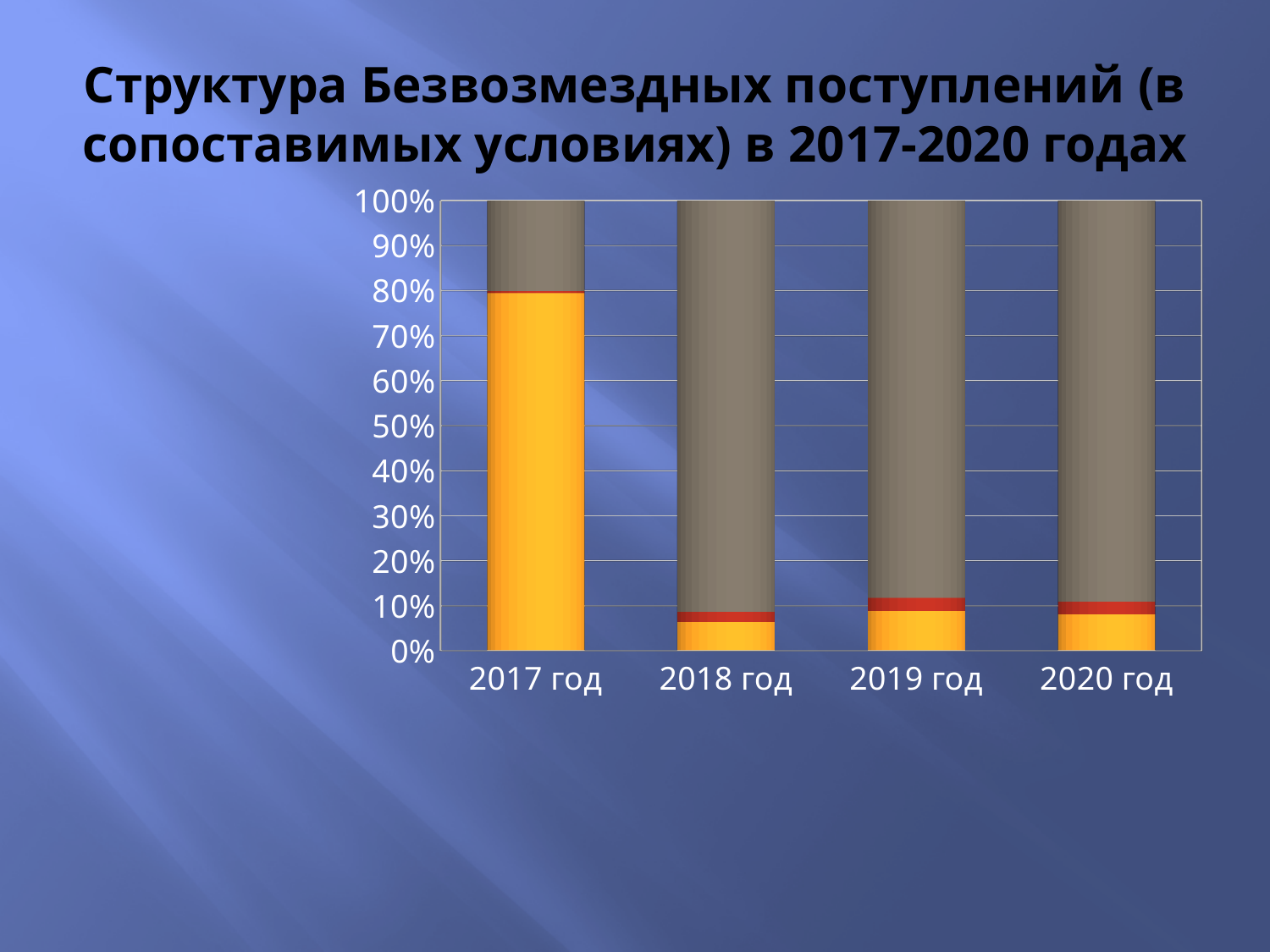
Is the yellow segment for 2017 год greater or less than 90%? less Is the yellow segment for 2017 год greater or less than 70%? greater What is the title of the chart on the slide? Структура Безвозмездных поступлений (в сопоставимых условиях) в 2017-2020 годах How many years (categories) are shown on the x axis? 4 Which year has the largest yellow segment? 2017 год Does the yellow segment rise or fall from 2017 год to 2018 год? fall Which year has a larger yellow segment, 2017 год or 2018 год? 2017 год What kind of chart is shown on the slide? Stacked bar chart Is the yellow segment for 2018 год greater or less than 10%? less What is the highest value shown on the vertical axis? 100% Which year has the smallest grey segment? 2017 год